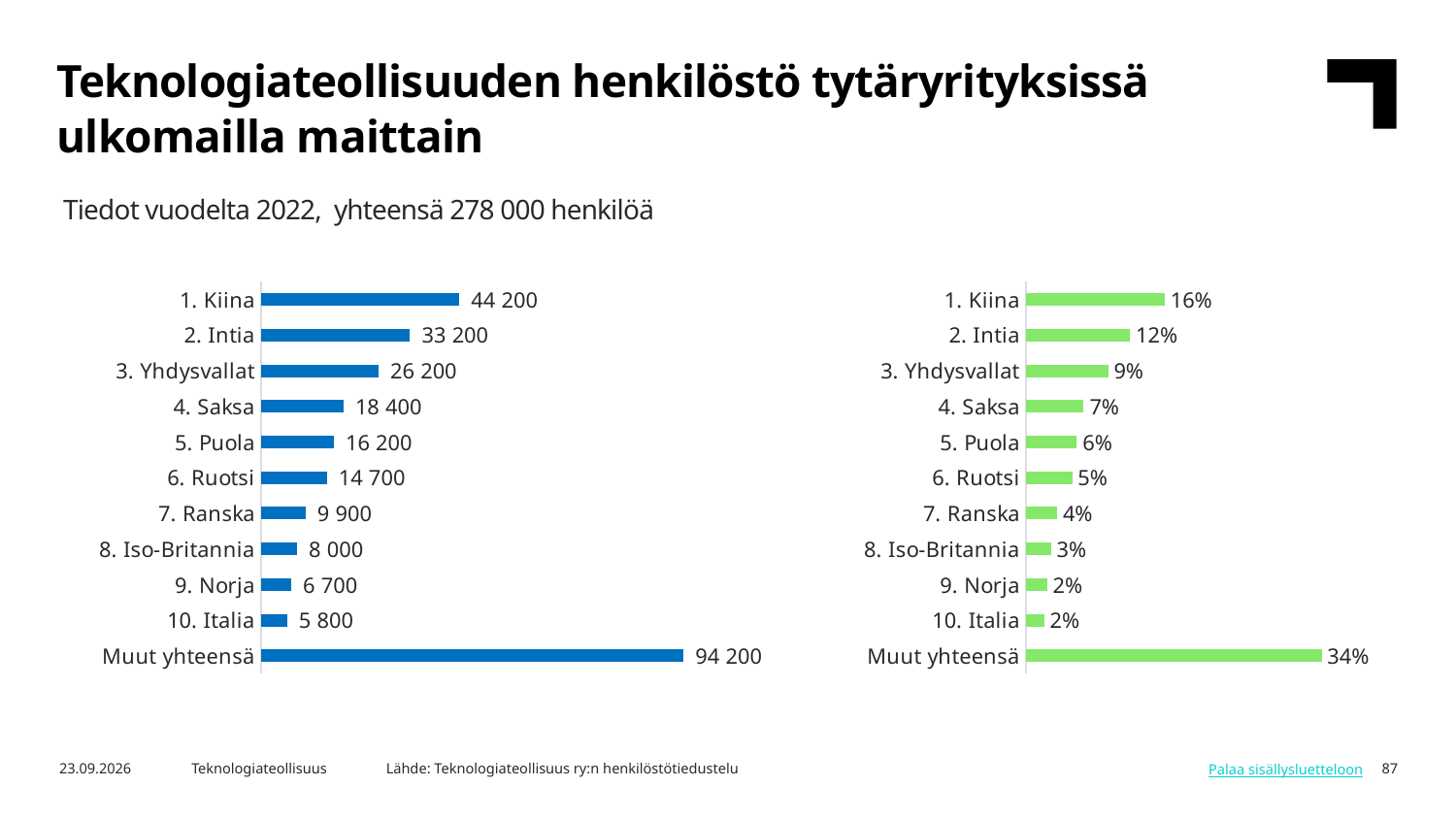
In the right chart, what is the difference between the values for 1. Kiina and 4. Saksa? 9% In the left chart, what is the value for 6. Ruotsi? 14 700 What colour are the bars in the right chart? Green In the left chart, which category has the lowest value? 10. Italia In the right chart, what is the value for Muut yhteensä? 34% How many categories are shown in the left chart? 11 In the left chart, what is the difference between the values for 1. Kiina and 2. Intia? 11 000 In the right chart, what is the value for 3. Yhdysvallat? 9% In the left chart, which category has the highest value? Muut yhteensä In the left chart, which is larger, the value for 4. Saksa or the value for 5. Puola? 4. Saksa What kind of chart is the right chart? Bar chart In the left chart, what is the value for 1. Kiina? 44 200